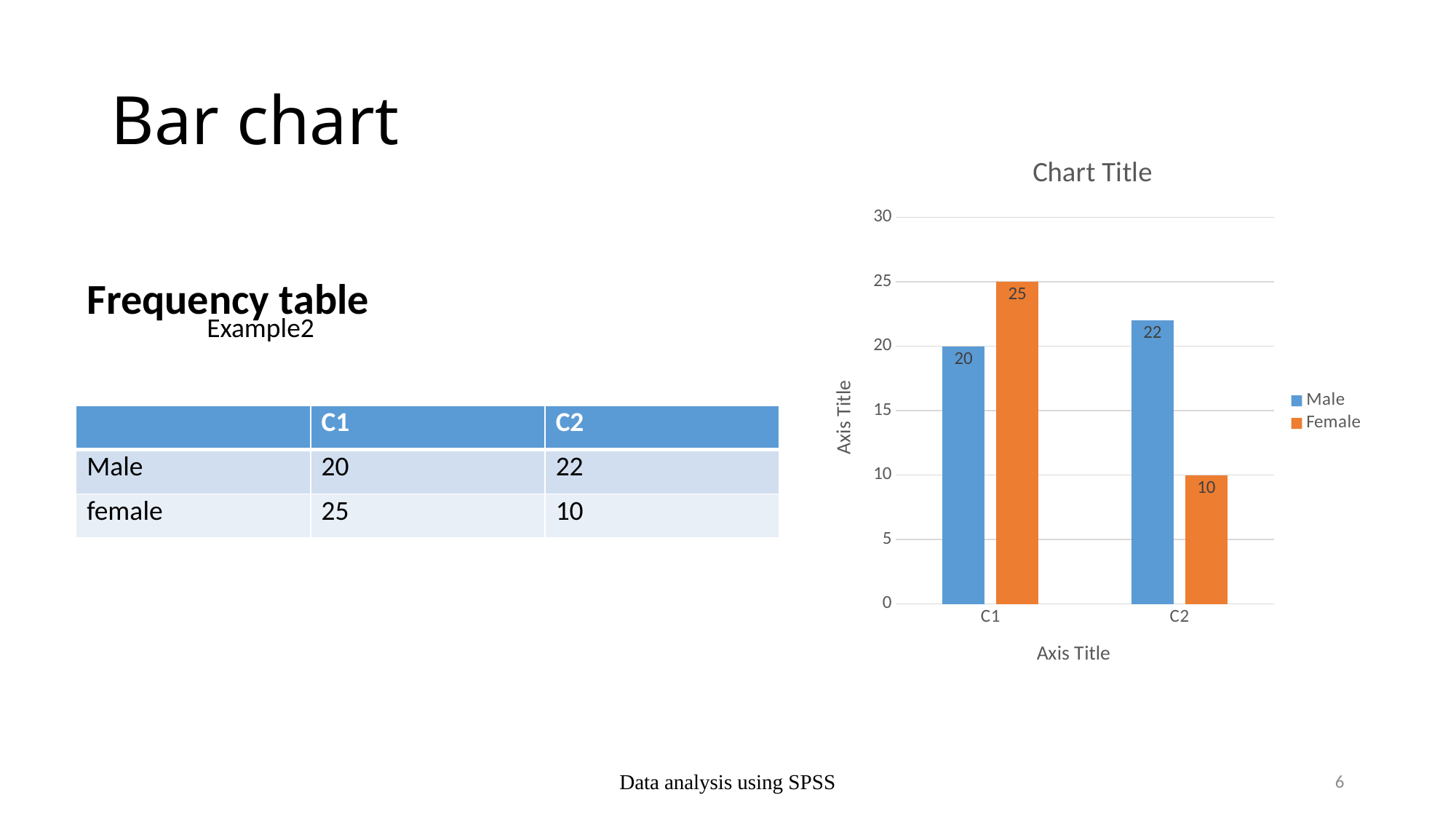
What is the value for Female in category C2? 10 What kind of chart is shown on the slide? Bar chart Which is larger, the Male value for C2 or the Female value for C2? Male What is the difference between the Female values for C1 and C2? 15 How many categories are shown on the x axis? 2 What colour are the Female bars? Orange What is the value for Male in category C2? 22 Which series has the highest value in category C1? Female Is the Female value for C1 greater or less than 20? greater How many series does the legend list? 2 Which bar has the lowest value on the chart? Female in C2 What is the value for Male in category C1? 20